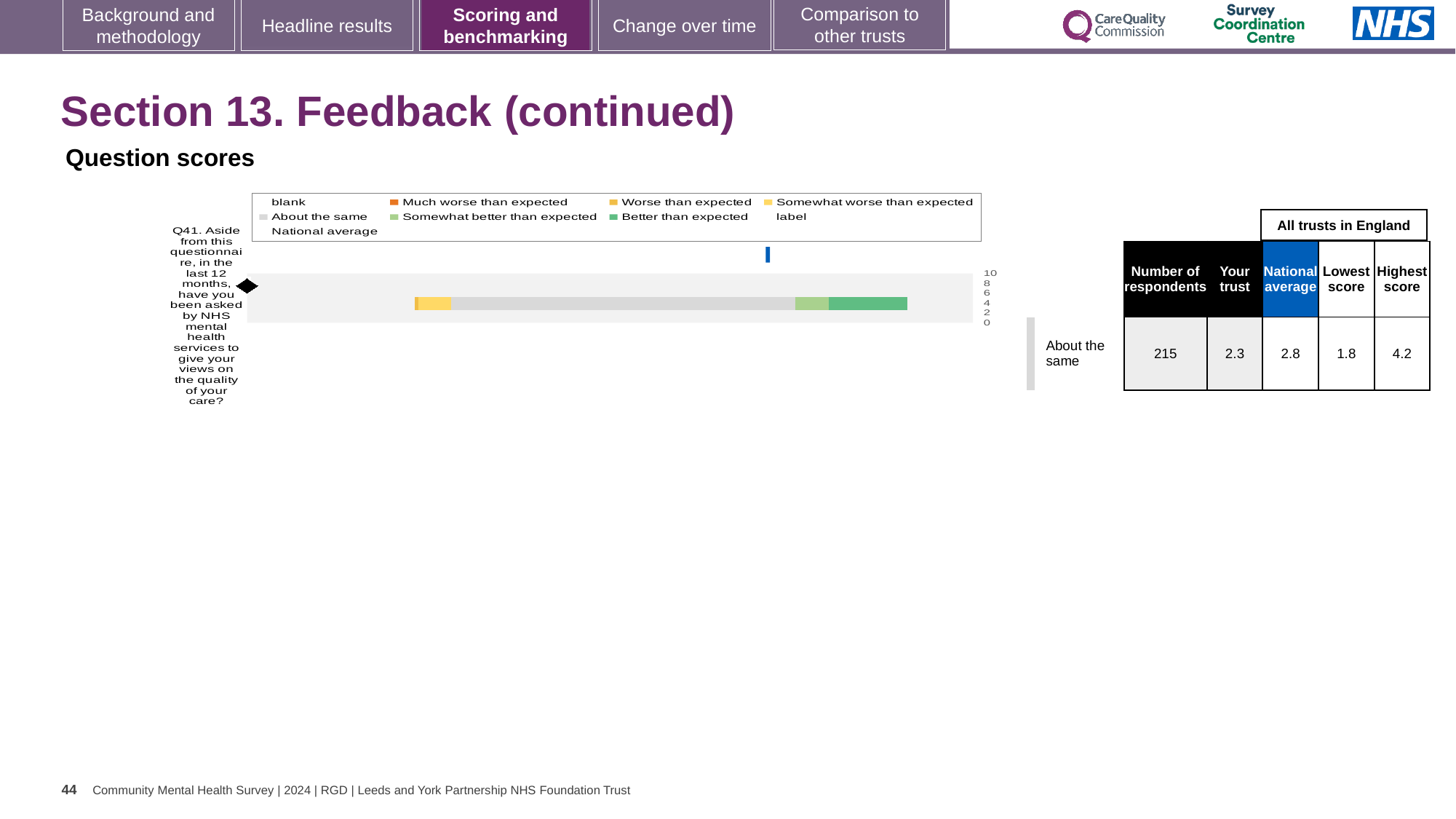
What is the 'Your trust' score for Q41? 2.3 What kind of chart is used to show the Q41 question score? bar chart How many respondents answered Q41? 215 Which is larger for Q41: the trust's score or the national average? National average What is the difference between the highest and lowest trust scores for Q41? 2.4 What is the national average score for Q41? 2.8 What is the highest score among all trusts in England for Q41? 4.2 Which legend entry is shown in dark green? Better than expected What benchmark category is shown next to the Q41 bar? About the same By how much does the national average exceed the trust's score for Q41? 0.5 What is the lowest score among all trusts in England for Q41? 1.8 How many survey questions are plotted in the chart? 1